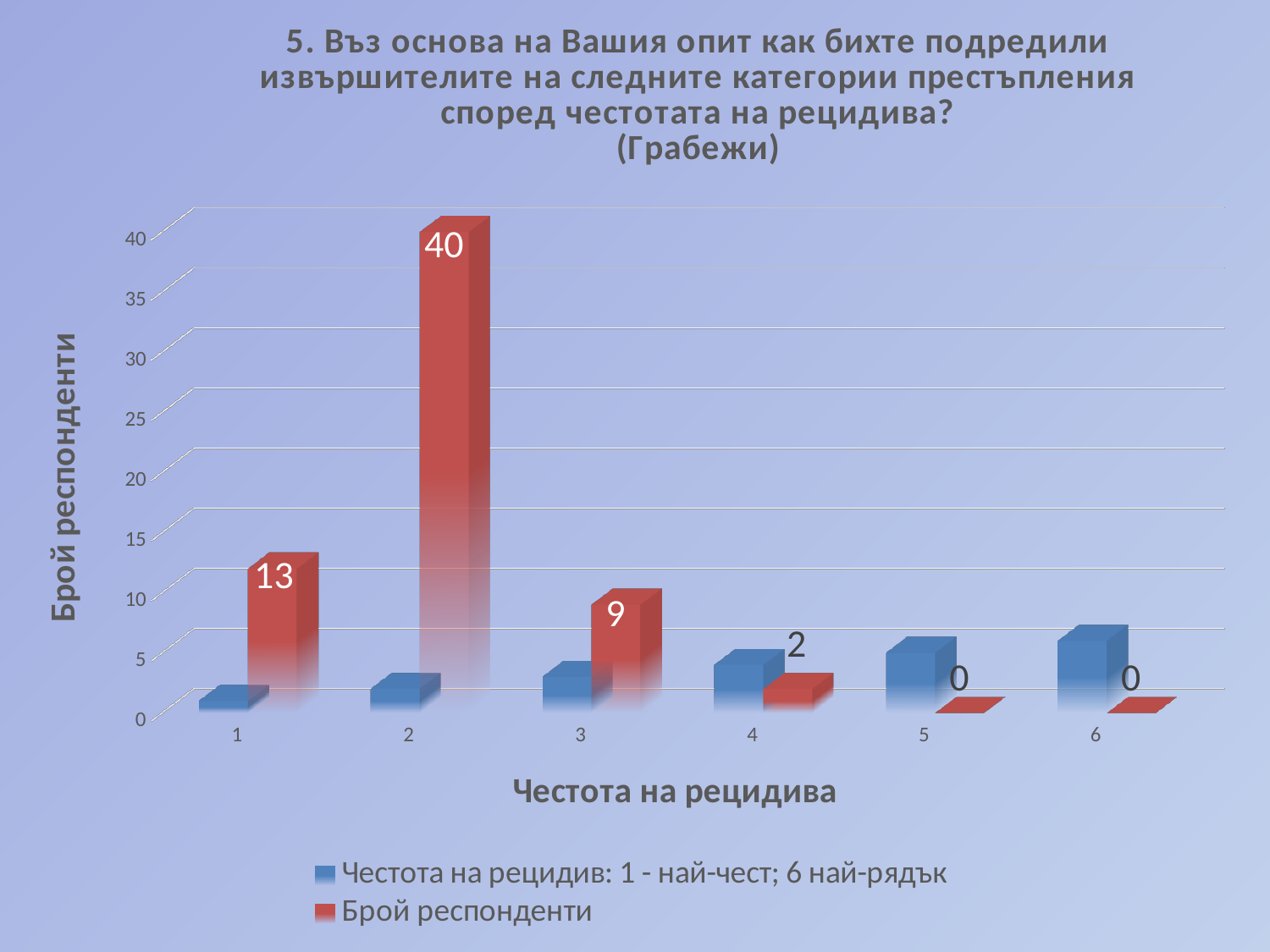
Which category has the highest value for Брой респонденти? 2 What is the value of Брой респонденти for category 3? 9 How many series does the legend list? 2 Is the blue bar for category 1 greater or less than 5? less Which is larger, the Брой респонденти value for category 1 or for category 3? category 1 Is the Брой респонденти value for category 2 greater or less than 35? greater How many categories are shown on the x axis? 6 What is the difference between the Брой респонденти values for categories 2 and 1? 27 What is the value of Брой респонденти for category 2? 40 What is the value of Брой респонденти for category 4? 2 What is the value of Брой респонденти for category 1? 13 What kind of chart is shown on the slide? bar chart